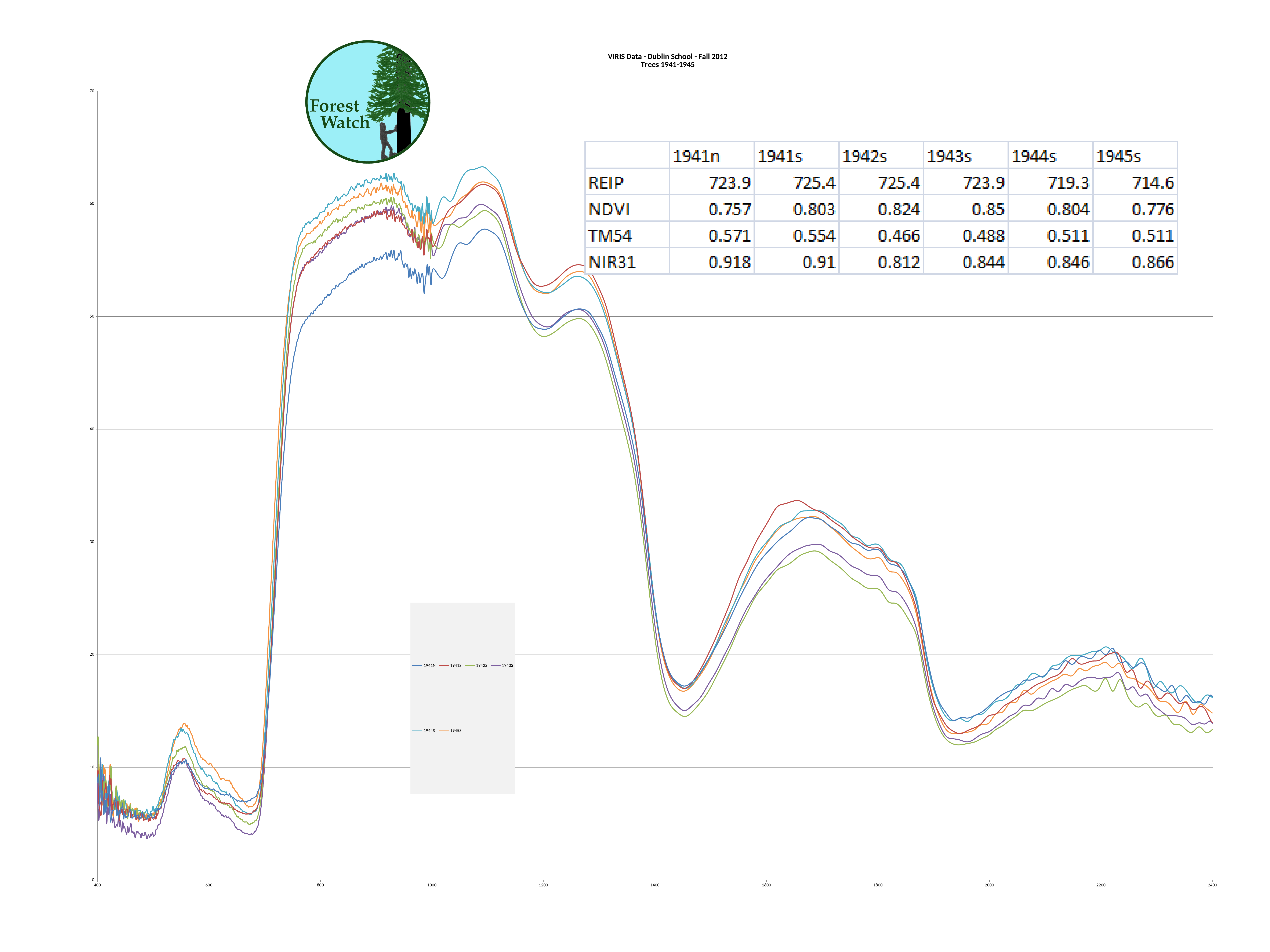
Which series has the lowest value at around 500 on the x axis? 1943S What kind of chart is shown on the slide? line chart Which series has the highest value at around 900 on the x axis? 1944S What is the highest value shown on the y axis? 70 How many series does the chart's legend list? 6 Do the series rise or fall between 1100 and 1450 on the x axis? fall What is the title of the chart? VIRIS Data - Dublin School - Fall 2012 Trees 1941-1945 Is the value for 1941S at 2000 on the x axis greater or less than 20? less Is the value for 1941S at 1700 on the x axis greater or less than 30? greater Is the value for 1941N at 1000 on the x axis greater or less than 50? greater Which series has the lowest value at around 900 on the x axis? 1941N